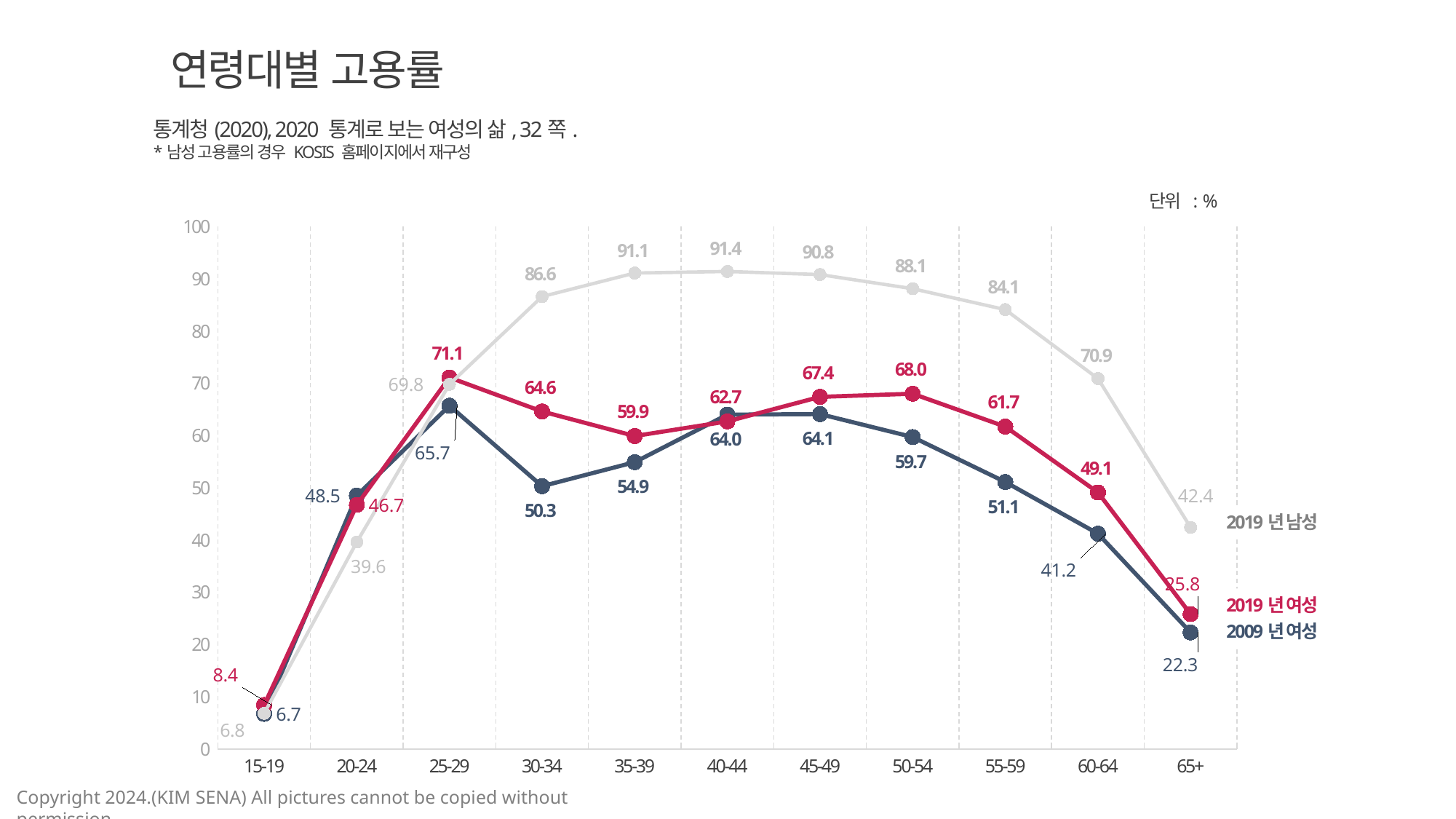
What unit is indicated for the values on the chart? % Which age group has the highest value for 2019년 여성? 25-29 How many age groups are plotted on the x axis? 11 What is the value for 2019년 남성 in the 40-44 age group? 91.4 What is the difference between 2019년 여성 and 2009년 여성 in the 30-34 age group? 14.3 What is the value for 2019년 여성 in the 25-29 age group? 71.1 What type of chart is shown on the slide? line chart How many series does the chart show? 3 Does the 2019년 남성 line rise or fall from 55-59 to 65+? fall What is the value for 2009년 여성 in the 30-34 age group? 50.3 Which age group has the lowest value for 2019년 남성? 15-19 In the 20-24 age group, which is larger: 2019년 여성 or 2009년 여성? 2009년 여성